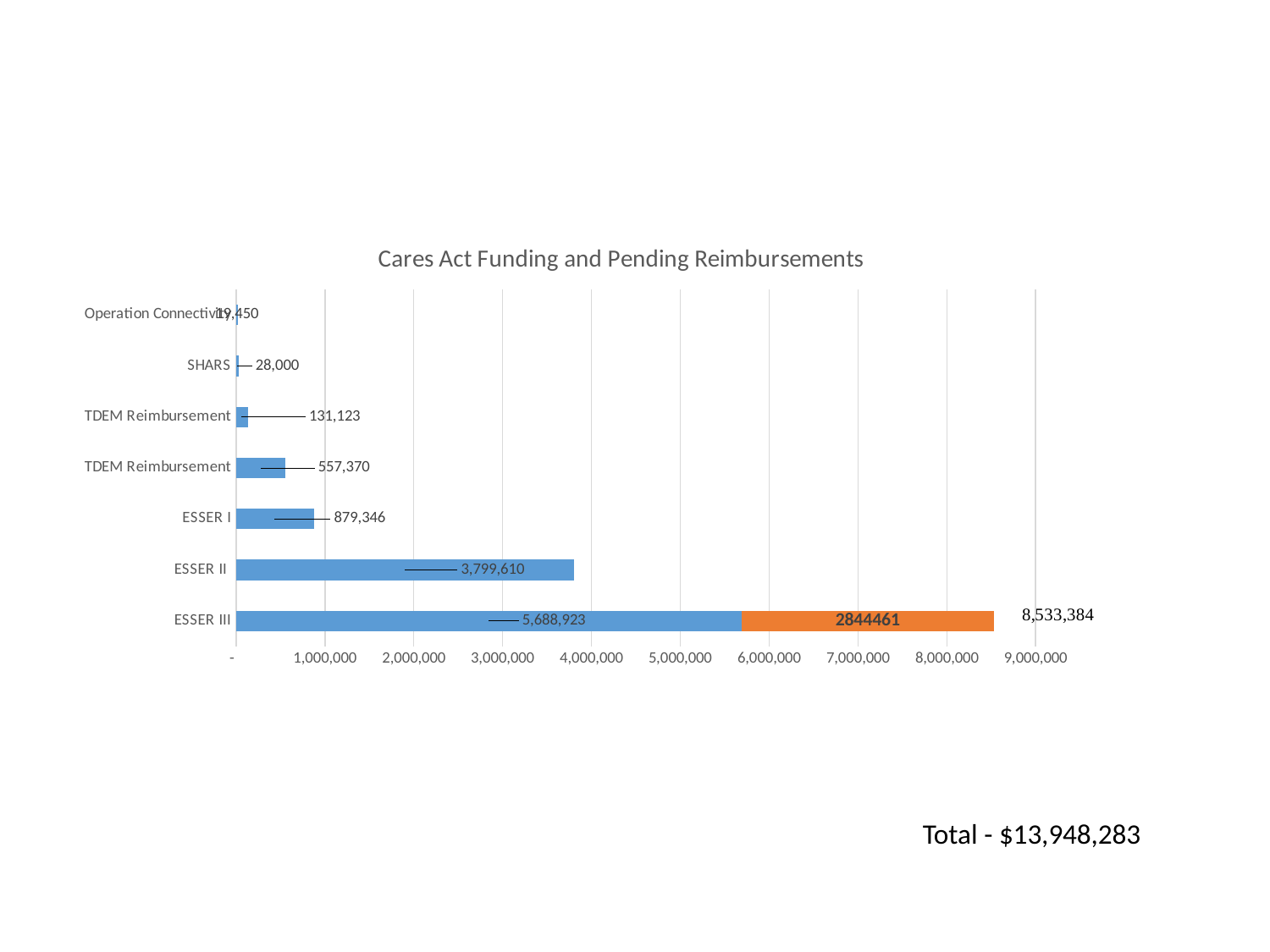
Which category has the longest bar? ESSER III What is the value shown for ESSER II? 3,799,610 What is the value shown for ESSER I? 879,346 What is the title of the chart? Cares Act Funding and Pending Reimbursements What is the value shown for SHARS? 28,000 What is the total of the stacked ESSER III bar? 8,533,384 What is the value of the orange segment of the ESSER III bar? 2844461 What is the difference between the ESSER II value and the ESSER I value? 2,920,264 How many categories are shown on the chart? 7 Which category has the shortest bar? Operation Connectivity What kind of chart is shown on the slide? bar chart What is the value of the blue segment of the ESSER III bar? 5,688,923